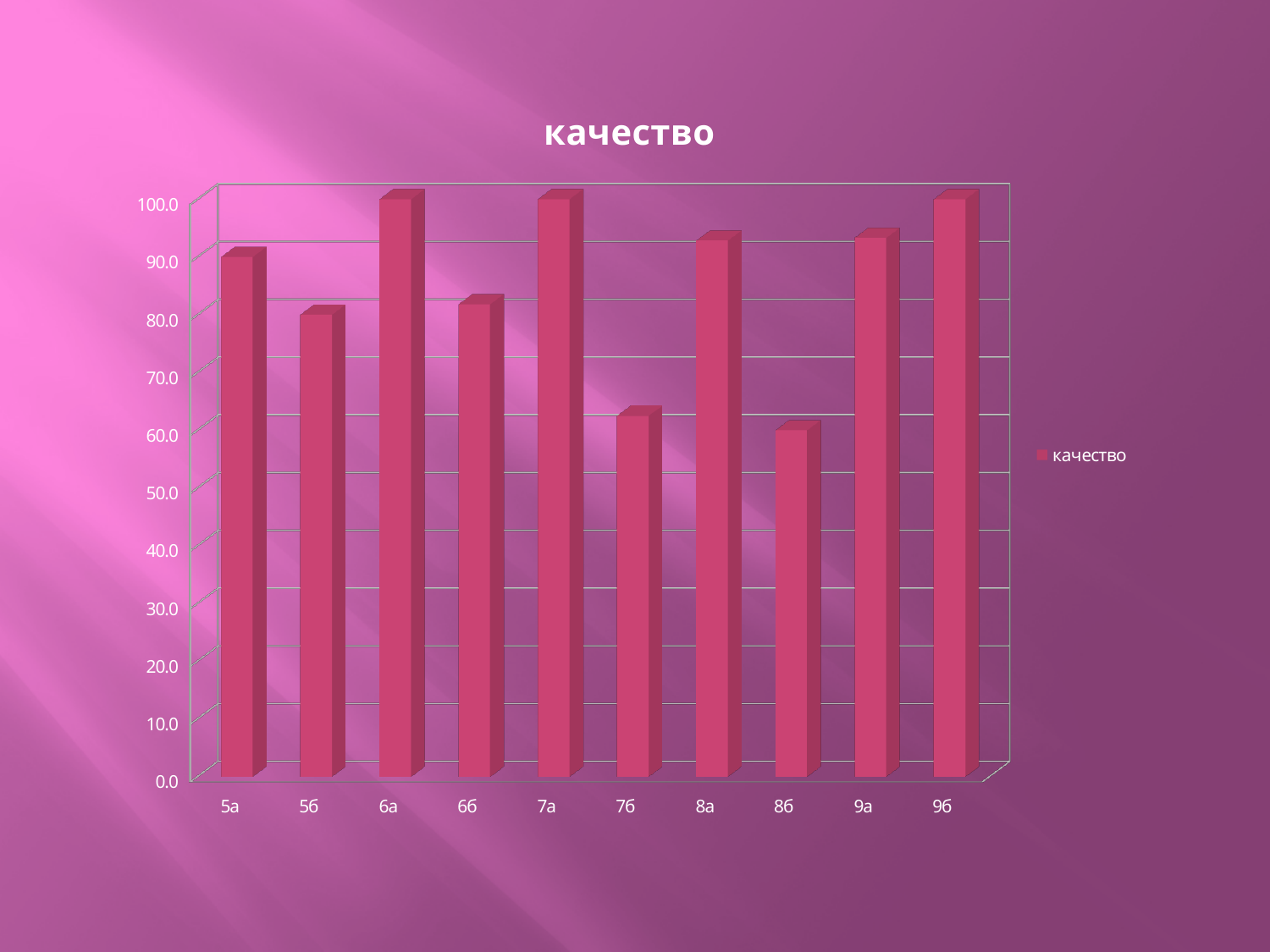
Is the value for 8а greater or less than 90? greater How many categories are shown on the x axis of the chart? 10 Which is larger, the value for 6а or the value for 6б? 6а Is the value for 8б greater or less than 70? less Which is larger, the value for 5а or the value for 5б? 5а Is the value for 7б greater or less than 70? less Which is larger, the value for 7б or the value for 8а? 8а How many series does the legend list? 1 What kind of chart is shown on the slide? bar chart What is the title of the chart? качество